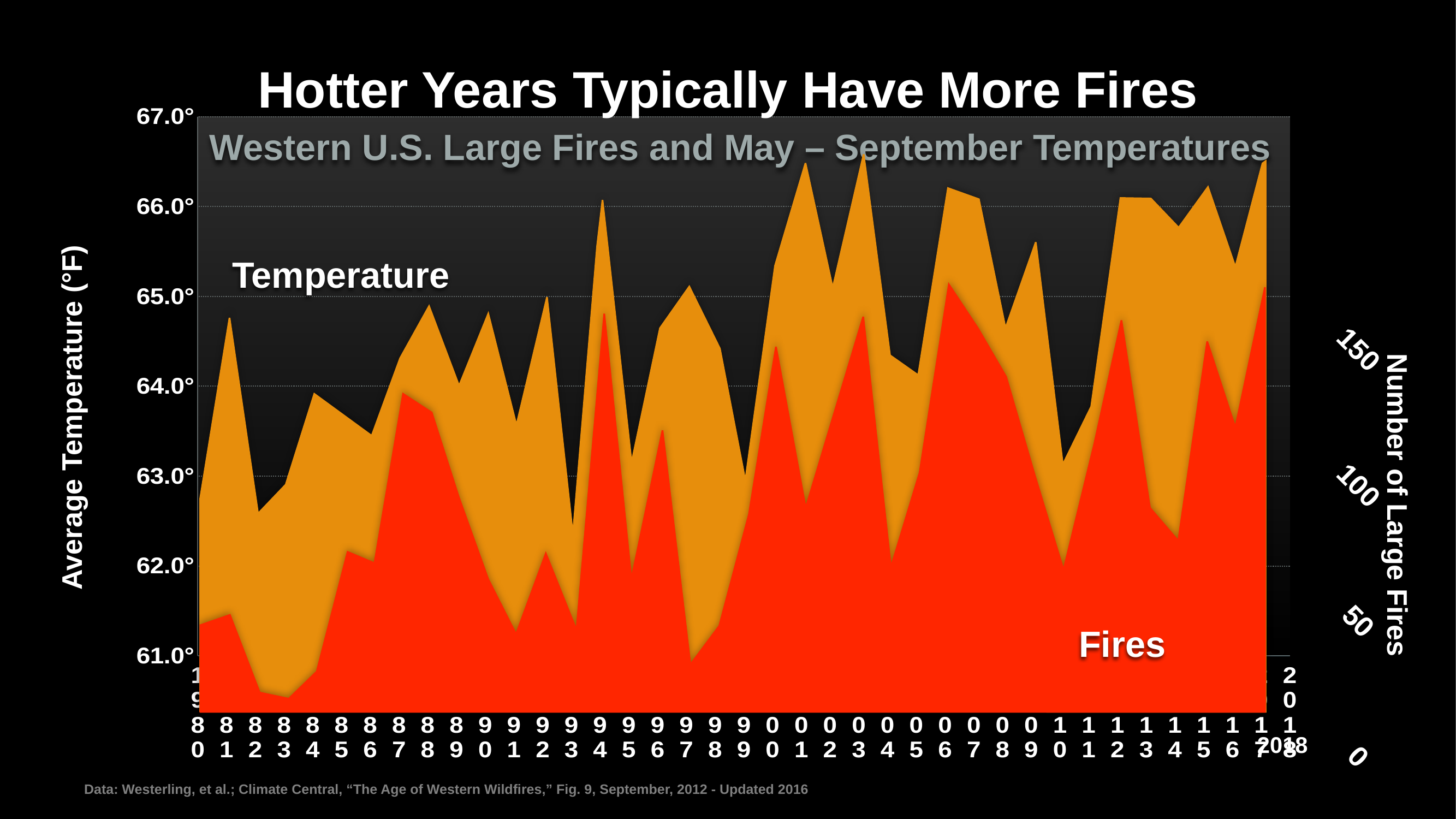
Which year has more large fires, 2006 or 2010? 2006 Is the temperature value for 1982 greater or less than 63.0°? less What kind of chart is shown on the slide? Area chart Which year has the higher temperature, 1981 or 1982? 1981 Is the number of large fires in 1983 greater or less than 50? less Is the temperature value for 2003 greater or less than 66.0°? greater How many data series are plotted on the chart? 2 What is the label of the left vertical axis? Average Temperature (°F) What is the title of the chart? Hotter Years Typically Have More Fires Overall, does the number of large fires rise or fall from 1980 to the end of the series? rise